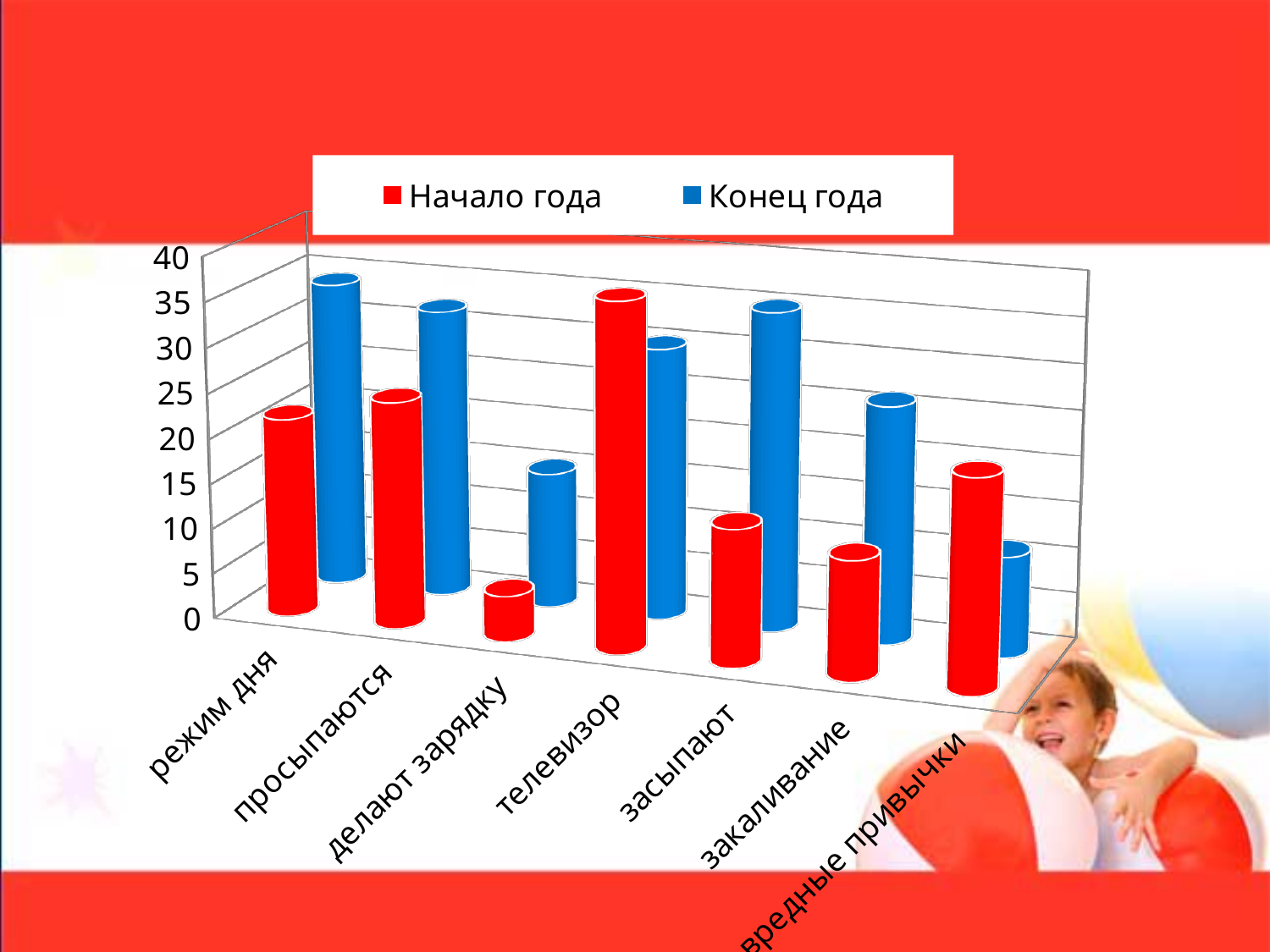
Which category has the highest value for Начало года? телевизор What kind of chart is shown on the slide? bar chart For режим дня, which series has the larger value, Начало года or Конец года? Конец года For засыпают, which series has the larger value, Начало года or Конец года? Конец года For вредные привычки, which series has the larger value, Начало года or Конец года? Начало года How many categories are shown on the x axis? 7 Which colour represents the Начало года series in the legend? red Is the value for режим дня in the Конец года series greater or less than 25? greater Is the value for делают зарядку in the Начало года series greater or less than 10? less Which category has the lowest value for Конец года? вредные привычки Which category has the lowest value for Начало года? делают зарядку How many series does the legend list? 2